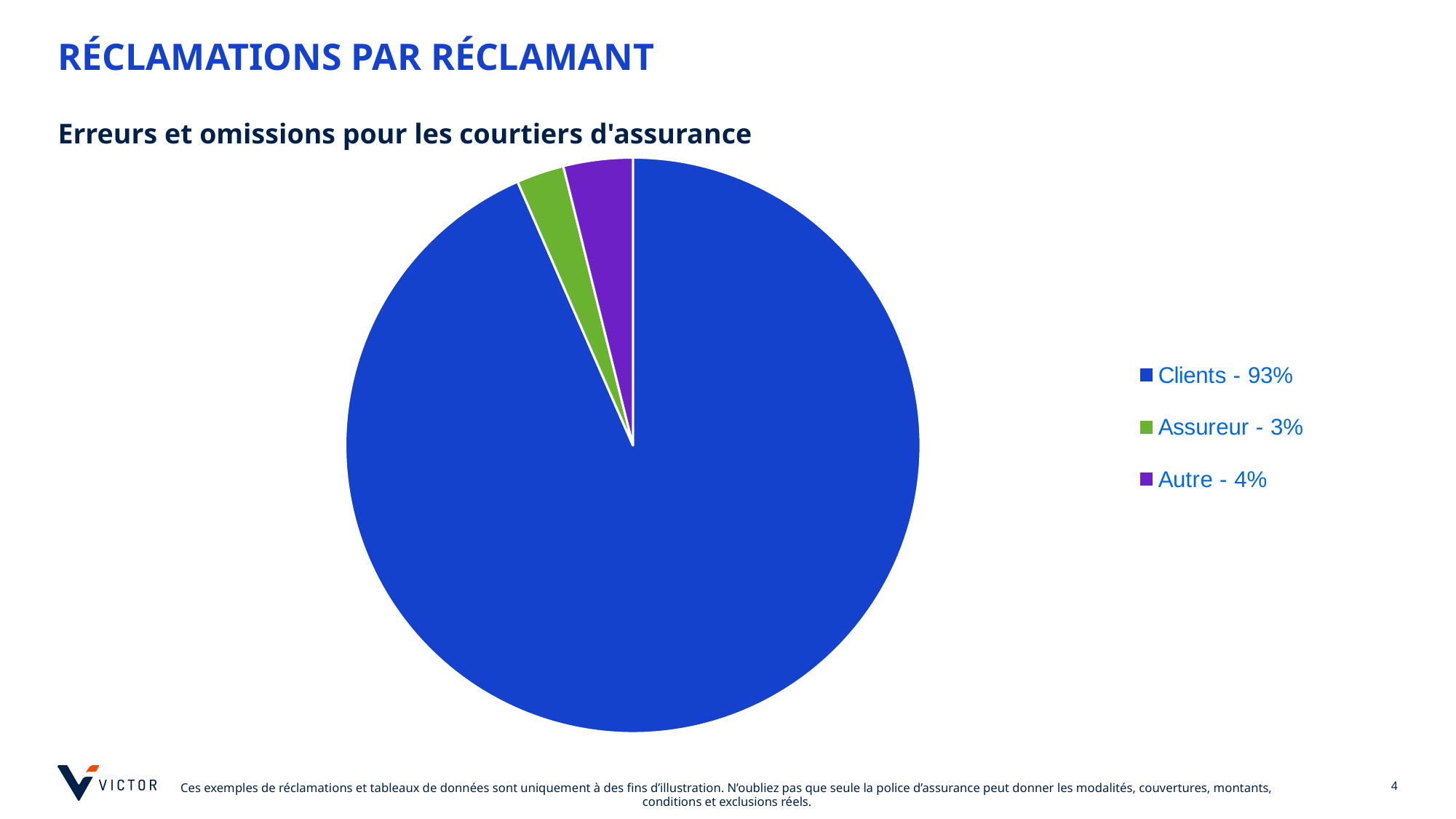
Which is larger, the share for Autre or the share for Assureur? Autre How many categories does the pie chart show? 3 What kind of chart is shown on the slide? pie chart What colour is the Assureur slice? green What share of the pie does Autre represent? 4% Which category has the smallest slice of the pie? Assureur What is the difference in percentage points between Clients and Autre? 89 What is the difference in percentage points between Autre and Assureur? 1 What share of the pie does Clients represent? 93% What is the subtitle shown above the chart? Erreurs et omissions pour les courtiers d'assurance What share of the pie does Assureur represent? 3% Which category has the largest slice of the pie? Clients